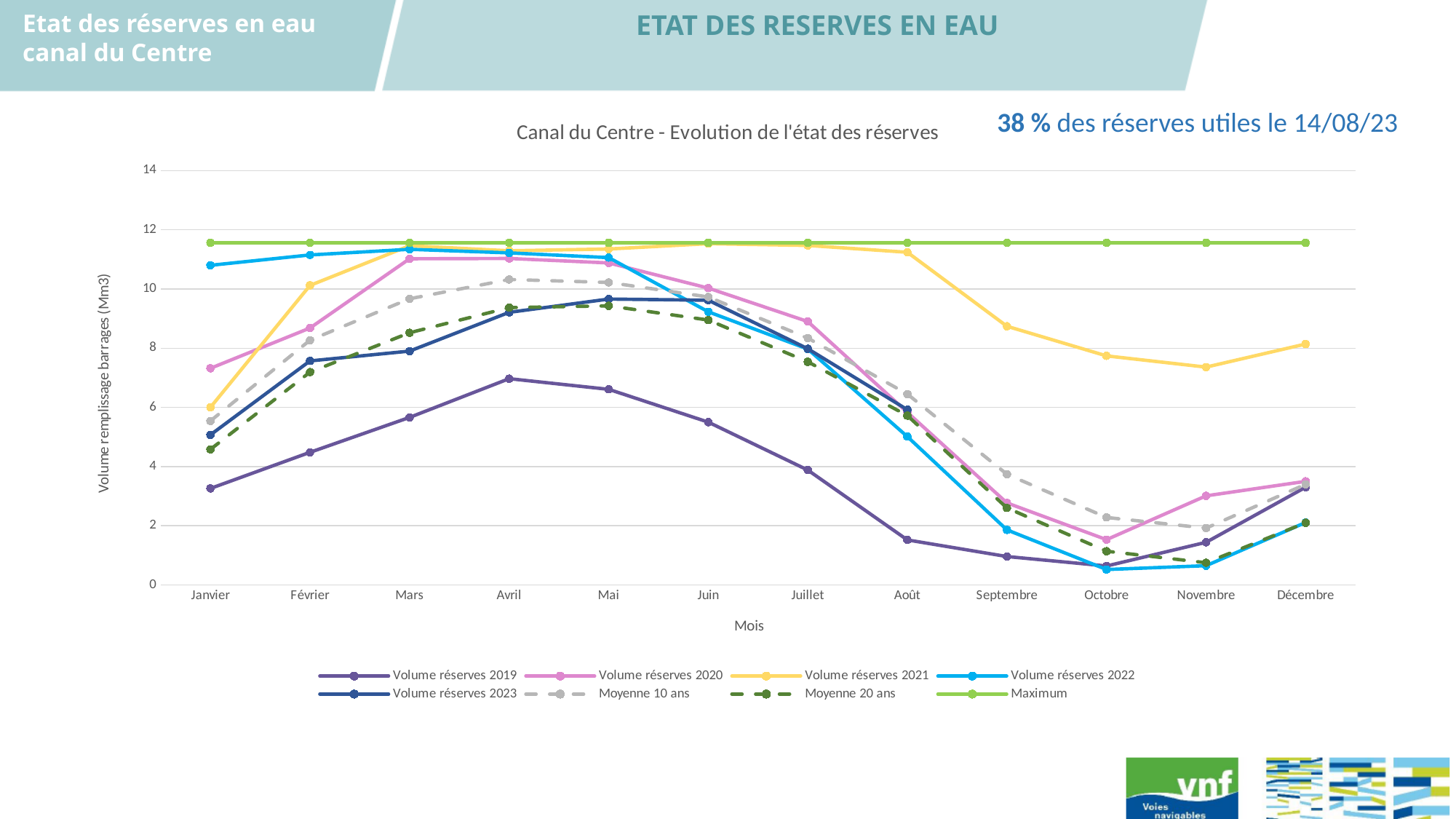
Does Volume réserves 2019 rise or fall from Avril to Août? fall In which month does Volume réserves 2020 reach its lowest value? Octobre What is the title of the chart? Canal du Centre - Evolution de l'état des réserves What is the label of the vertical axis? Volume remplissage barrages (Mm3) In Août, which is larger: Volume réserves 2021 or Volume réserves 2019? Volume réserves 2021 Is the value for Volume réserves 2022 in Octobre greater or less than 2? less Is the value for Volume réserves 2019 in Janvier greater or less than 4? less Is the value for Volume réserves 2021 in Septembre greater or less than 8? greater How many series does the chart legend list? 8 In which month does Volume réserves 2019 reach its highest value? Avril What kind of chart is shown on the slide? line chart How many months are plotted along the x axis? 12